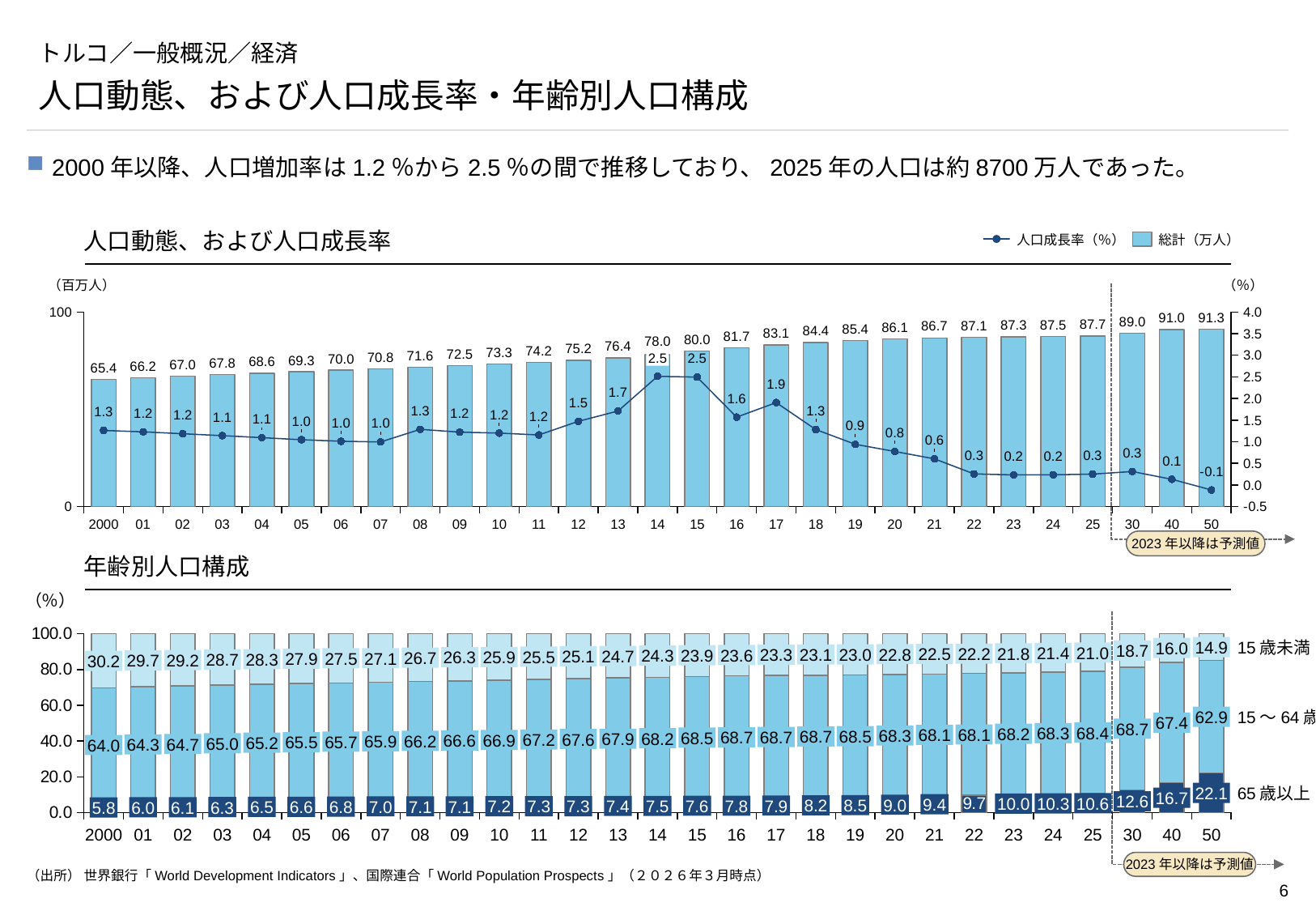
In the bottom chart (年齢別人口構成), what is the 65歳以上 value for 40? 16.7 In the top chart (人口動態、および人口成長率), how many years are shown on the x axis? 29 In the top chart (人口動態、および人口成長率), what is the 人口成長率 value for 2021? 0.6 In the top chart (人口動態、および人口成長率), what is the difference between the 総計 values for 2025 and 2000? 22.3 In the top chart (人口動態、および人口成長率), what is the 総計 value for 2017? 83.1 What kind of chart is the bottom chart (年齢別人口構成)? Stacked bar chart In the top chart (人口動態、および人口成長率), which year has the higher 人口成長率, 2017 or 2018? 2017 In the bottom chart (年齢別人口構成), what is the total of the stacked bar for 2000? 100.0 In the top chart (人口動態、および人口成長率), which year has the lowest 人口成長率? 50 In the bottom chart (年齢別人口構成), what is the difference between the 65歳以上 values for 50 and 2000? 16.3 In the top chart (人口動態、および人口成長率), how many series does the legend list? 2 In the bottom chart (年齢別人口構成), does the 15歳未満 share rise or fall from 2000 to 50? Fall